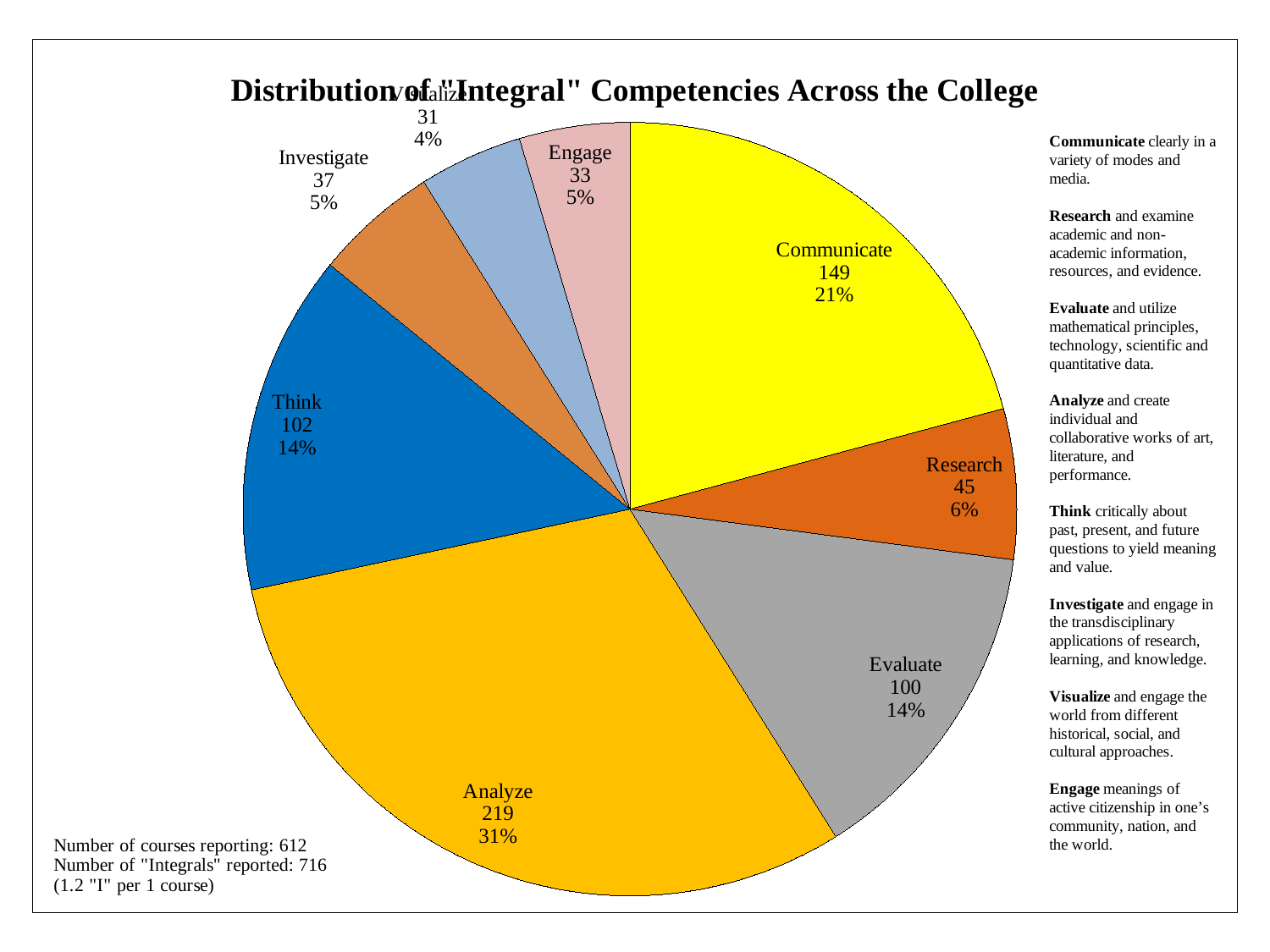
What is the title of the chart? Distribution of "Integral" Competencies Across the College Which competency has the largest slice? Analyze What is the value for Research? 45 What is the difference between the values for Analyze and Communicate? 70 Which competency has the smallest slice? Visualize What is the value for Communicate? 149 Which is larger, the value for Investigate or the value for Research? Research What share of the pie does Engage represent? 5% What is the value for Analyze? 219 What share of the pie does Think represent? 14% How many slices does the pie chart have? 8 What kind of chart is shown on the slide? pie chart